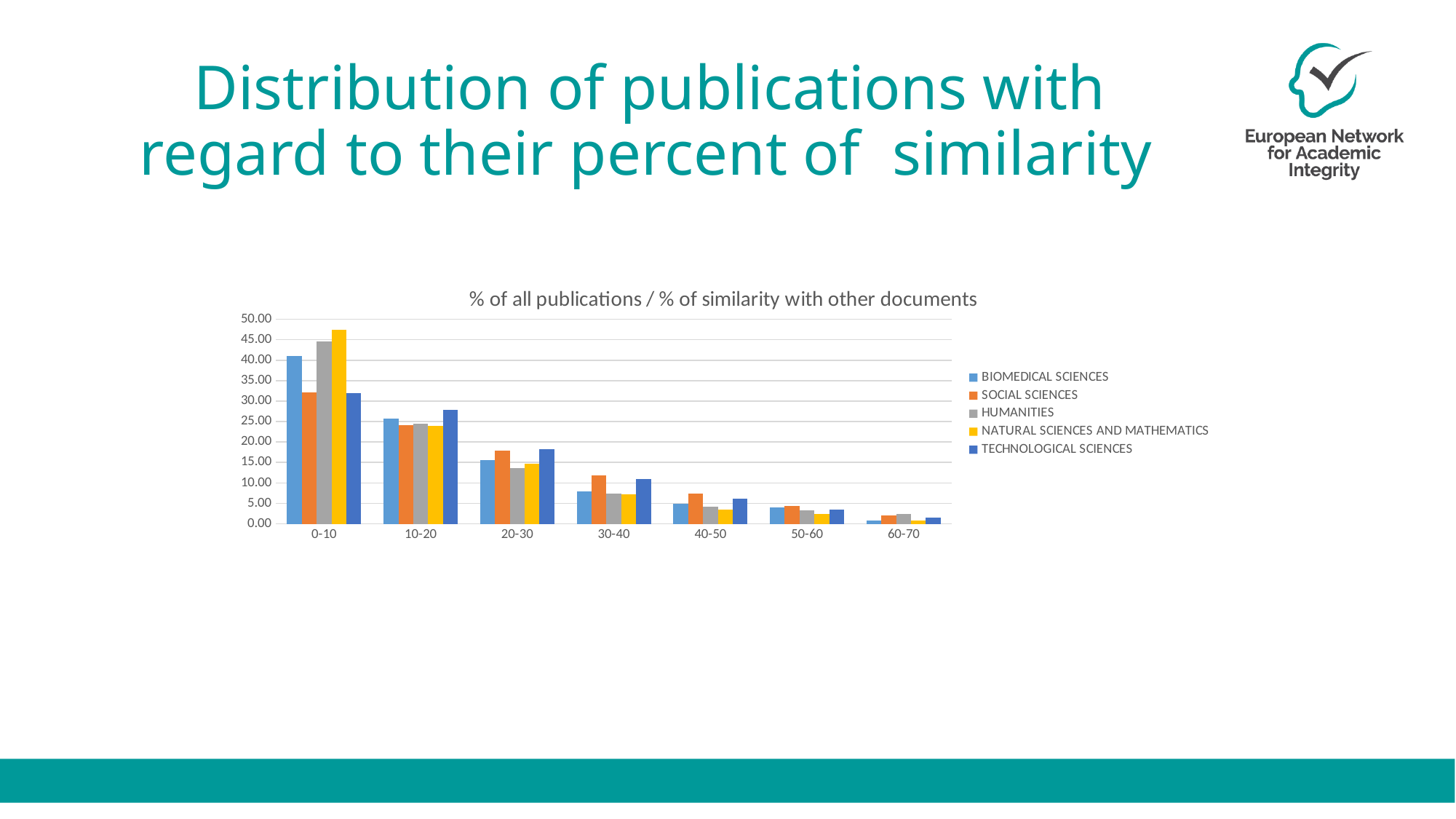
What is the title of the chart? % of all publications / % of similarity with other documents Is the value for Social Sciences in the 0-10 range greater or less than 35.00? less Do the values for Biomedical Sciences rise or fall as the similarity range increases from 0-10 to 60-70? fall In the 0-10 range, which series has the highest value? Natural Sciences and Mathematics What kind of chart is shown on the slide? Bar chart Is the value for Biomedical Sciences in the 0-10 range greater or less than 35.00? greater Is the value for Technological Sciences in the 10-20 range greater or less than 25.00? greater How many similarity ranges are shown on the x axis? 7 In the 20-30 range, which is larger: Social Sciences or Humanities? Social Sciences How many series does the legend list? 5 In the 30-40 range, which is larger: Social Sciences or Biomedical Sciences? Social Sciences